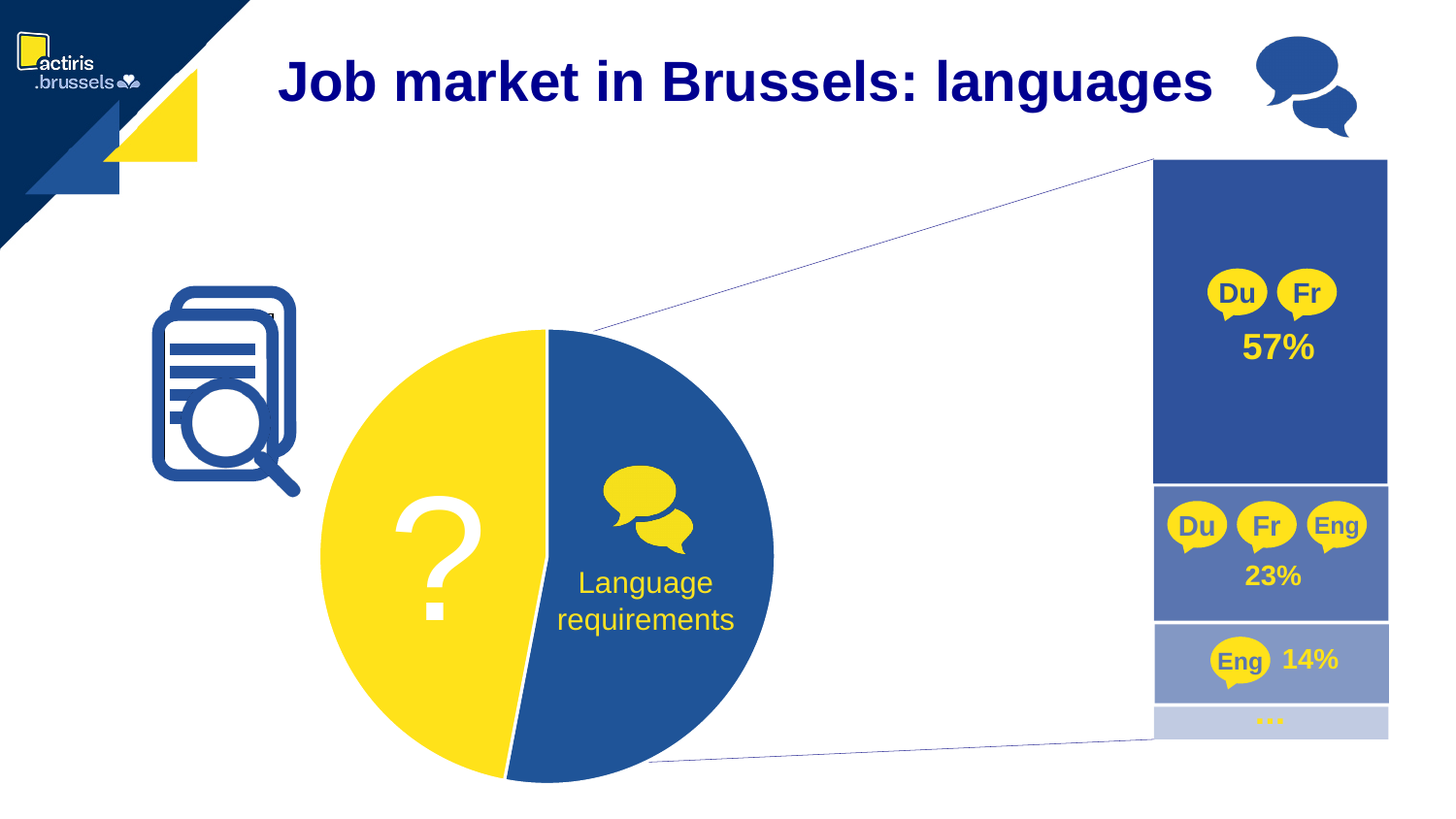
In the breakdown bar on the right, what percentage is shown for the Du Fr Eng segment? 23% In the breakdown bar on the right, which is larger: the Du Fr Eng percentage or the Eng percentage? Du Fr Eng In the breakdown bar on the right, which labelled language combination has the lowest percentage? Eng What kind of chart is the chart in the centre of the slide? pie chart In the breakdown bar on the right, which labelled language combination has the highest percentage? Du Fr How many slices does the pie chart have? 2 What is the label of the blue slice of the pie chart? Language requirements In the breakdown bar on the right, what is the difference between the Du Fr percentage and the Du Fr Eng percentage? 34% In the breakdown bar on the right, what percentage is shown for the Eng segment? 14% In the breakdown bar on the right, what percentage is shown for the Du Fr segment? 57% In the breakdown bar on the right, what do the three labelled segments (Du Fr, Du Fr Eng, Eng) add up to? 94% What is the title of the slide containing the charts? Job market in Brussels: languages